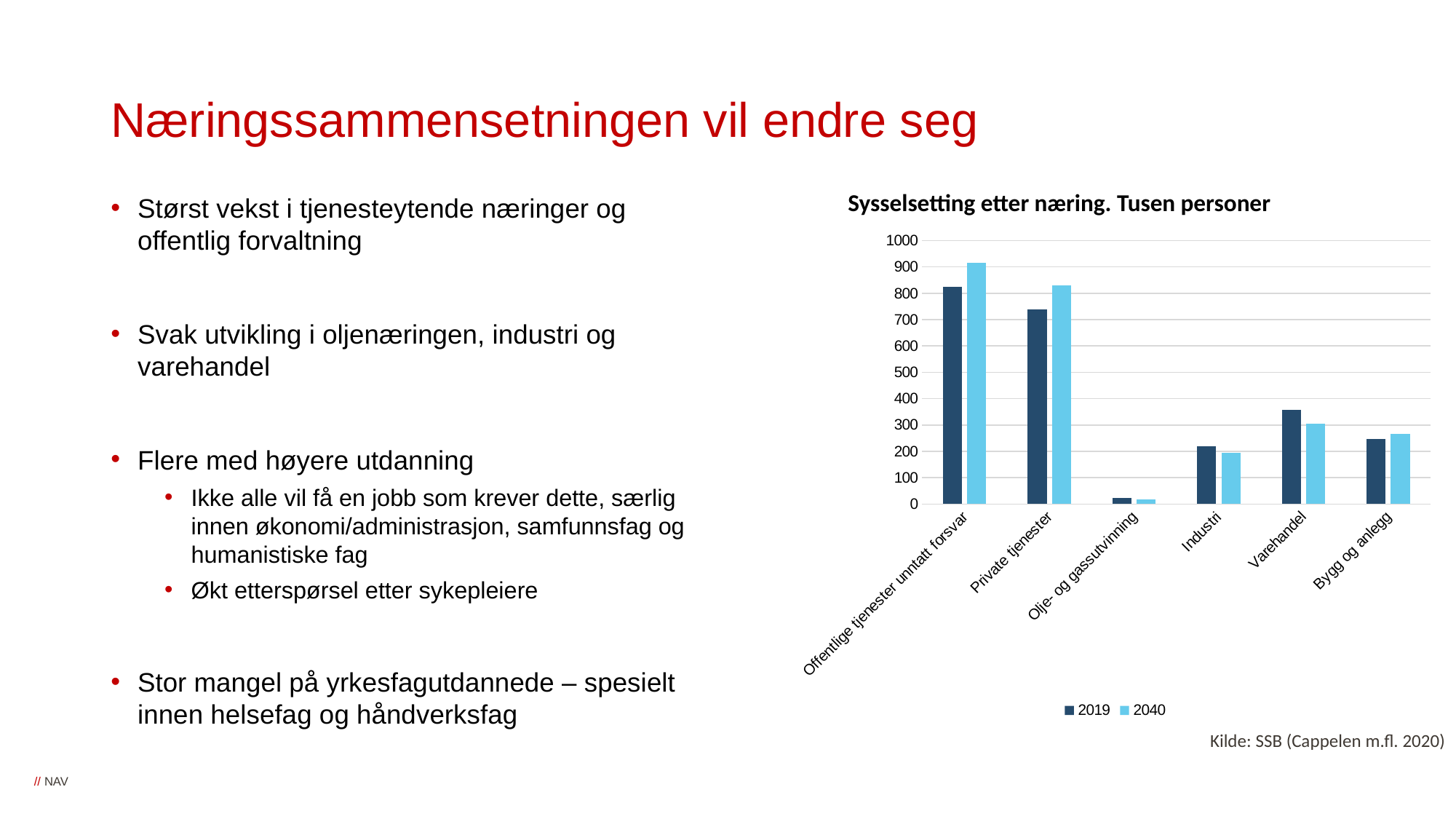
Is the 2040 value for Private tjenester greater or less than 800? greater What is the title of the chart? Sysselsetting etter næring. Tusen personer Which category has the highest value for 2040? Offentlige tjenester unntatt forsvar How many series does the chart's legend list? 2 For Varehandel, which series has the larger value, 2019 or 2040? 2019 For Bygg og anlegg, which series has the larger value, 2019 or 2040? 2040 What are the two entries in the chart's legend? 2019 and 2040 Which category has the lowest value for 2019? Olje- og gassutvinning How many industry categories are shown on the x axis of the chart? 6 Is the 2019 value for Offentlige tjenester unntatt forsvar greater or less than 700? greater What kind of chart is shown on the slide? Bar chart Is the 2019 value for Industri greater or less than 300? less